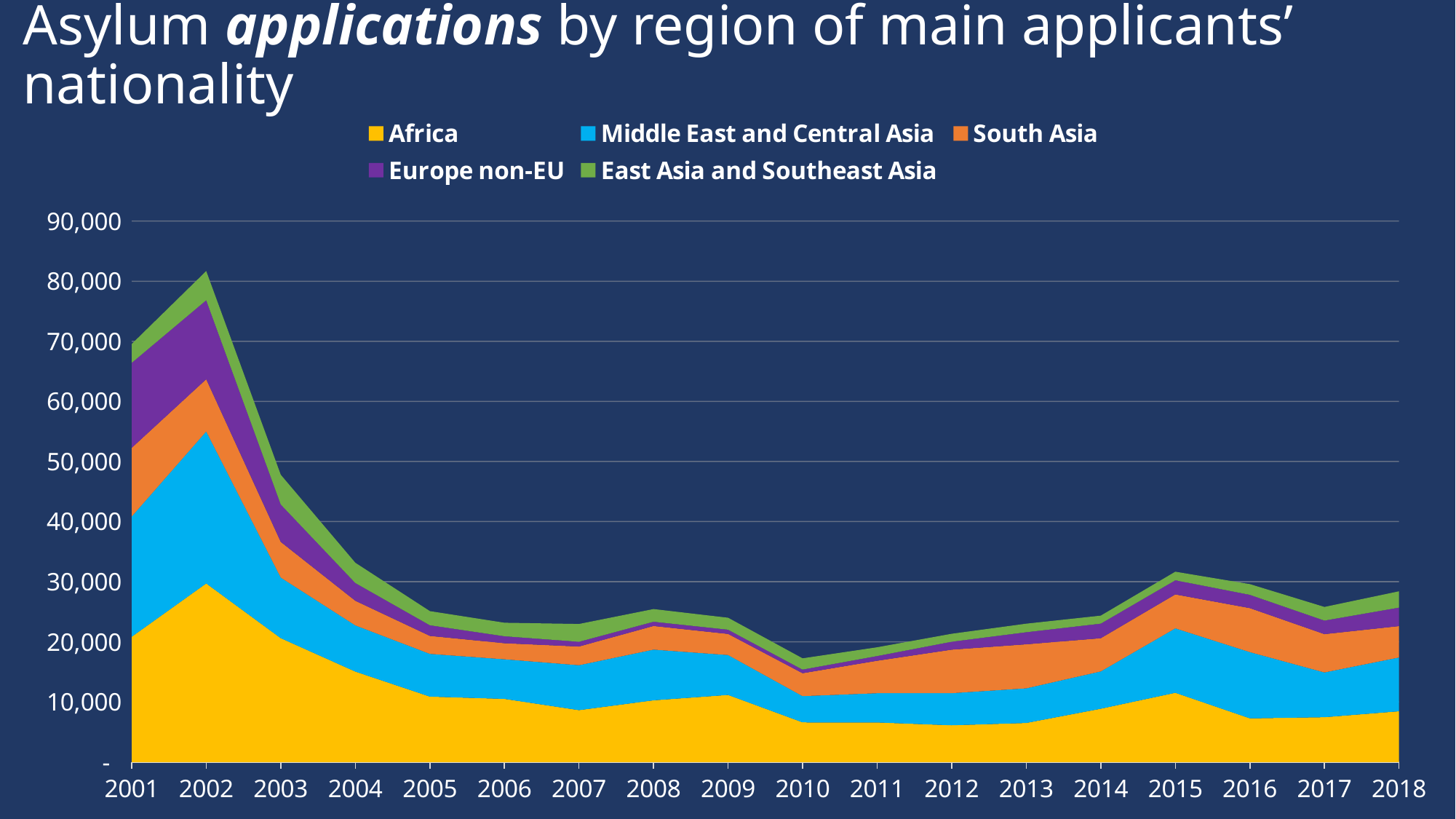
Is the total number of applications in 2002 greater or less than 70,000? greater Do total asylum applications rise or fall between 2002 and 2005? Fall Which year has the larger total number of applications, 2002 or 2015? 2002 In which year is the total number of asylum applications lowest? 2010 What kind of chart is shown on the slide? Stacked area chart How many series does the legend list? 5 How many years are shown along the x axis? 18 In which year is the total number of asylum applications highest? 2002 Is the value for Africa in 2002 greater or less than 20,000? greater Which colour represents Africa in the chart? Yellow Is the total number of applications in 2018 greater or less than 30,000? less